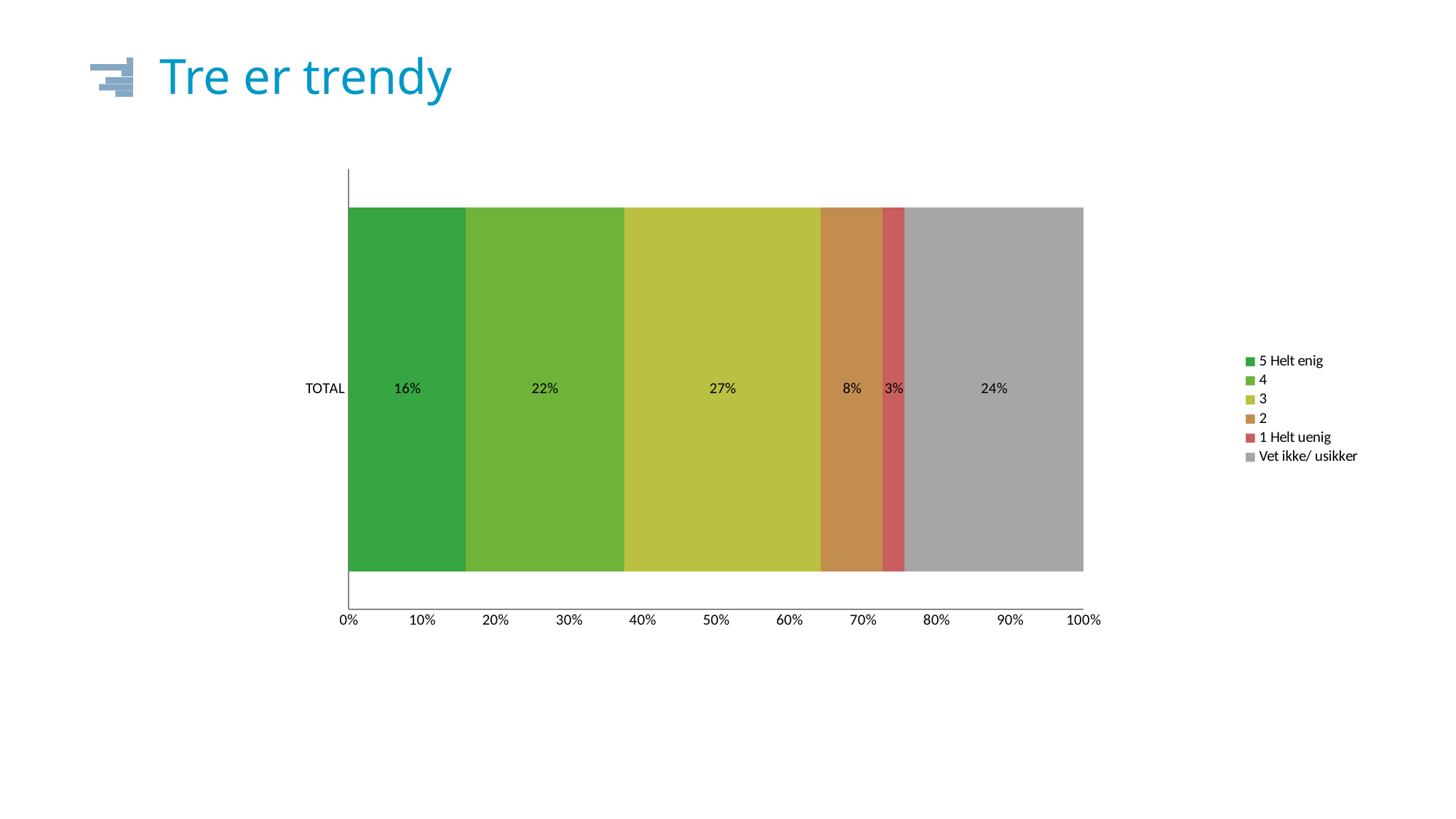
What is the title of the slide? Tre er trendy Which response category has the largest share in the TOTAL bar? 3 What kind of chart is shown on the slide? Stacked bar chart What is the difference between the '4' segment and the '2' segment? 14% Which is larger, the '5 Helt enig' segment or the 'Vet ikke/ usikker' segment? Vet ikke/ usikker What is the value for '1 Helt uenig'? 3% What is the value for the '3' segment of the TOTAL bar? 27% What share of the TOTAL bar is 'Vet ikke/ usikker'? 24% What percentage of respondents answered '5 Helt enig'? 16% Which response category has the smallest share in the TOTAL bar? 1 Helt uenig How many series does the legend list? 6 What is the combined share of '5 Helt enig' and '4'? 38%